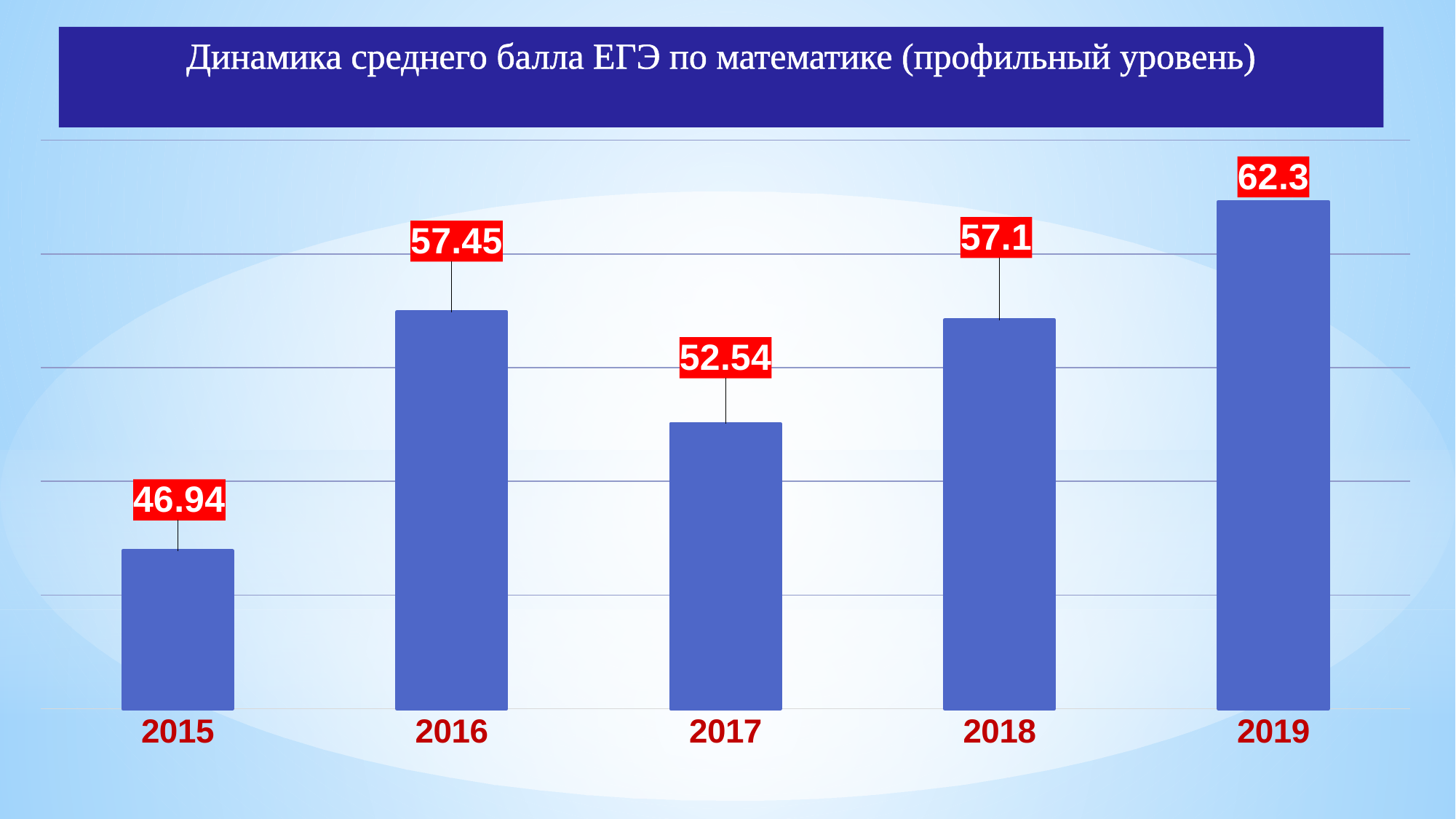
What is the value for 2018? 57.1 What is the value for 2017? 52.54 What is the difference between the values for 2016 and 2017? 4.91 How many years are shown on the chart? 5 What is the title of the chart? Динамика среднего балла ЕГЭ по математике (профильный уровень) Which year has the highest value? 2019 Which is larger, the value for 2016 or the value for 2017? 2016 What kind of chart is shown on the slide? Bar chart What is the value for 2019? 62.3 What is the difference between the values for 2019 and 2015? 15.36 Which year has the lowest value? 2015 What is the value for 2015? 46.94